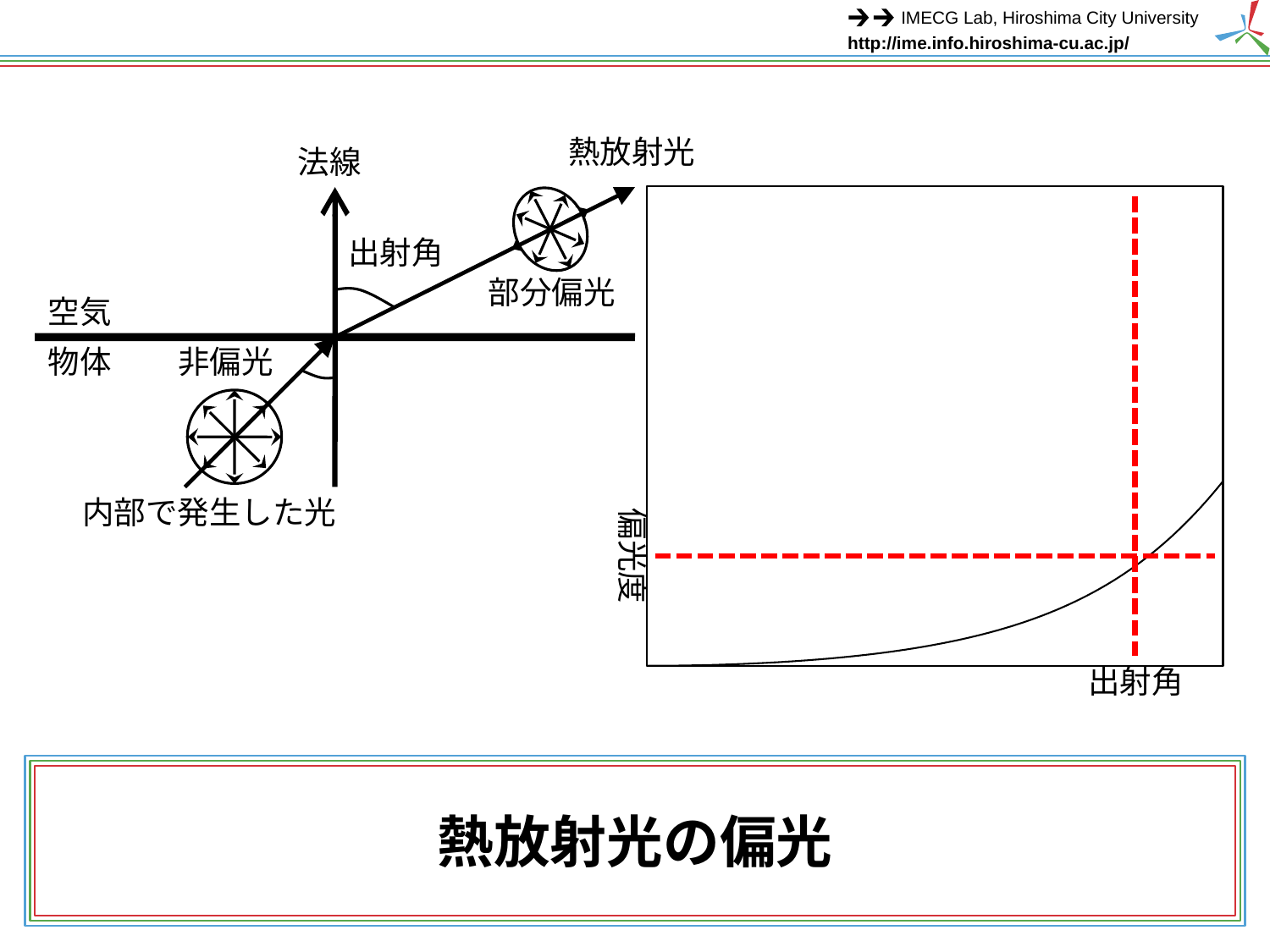
In the chart on the right, does the plotted curve rise or fall as the x axis (出射角) increases? rise What is the label of the vertical axis of the chart on the right? 偏光度 What kind of chart is shown on the right side of the slide? line chart What is the label of the horizontal axis of the chart on the right? 出射角